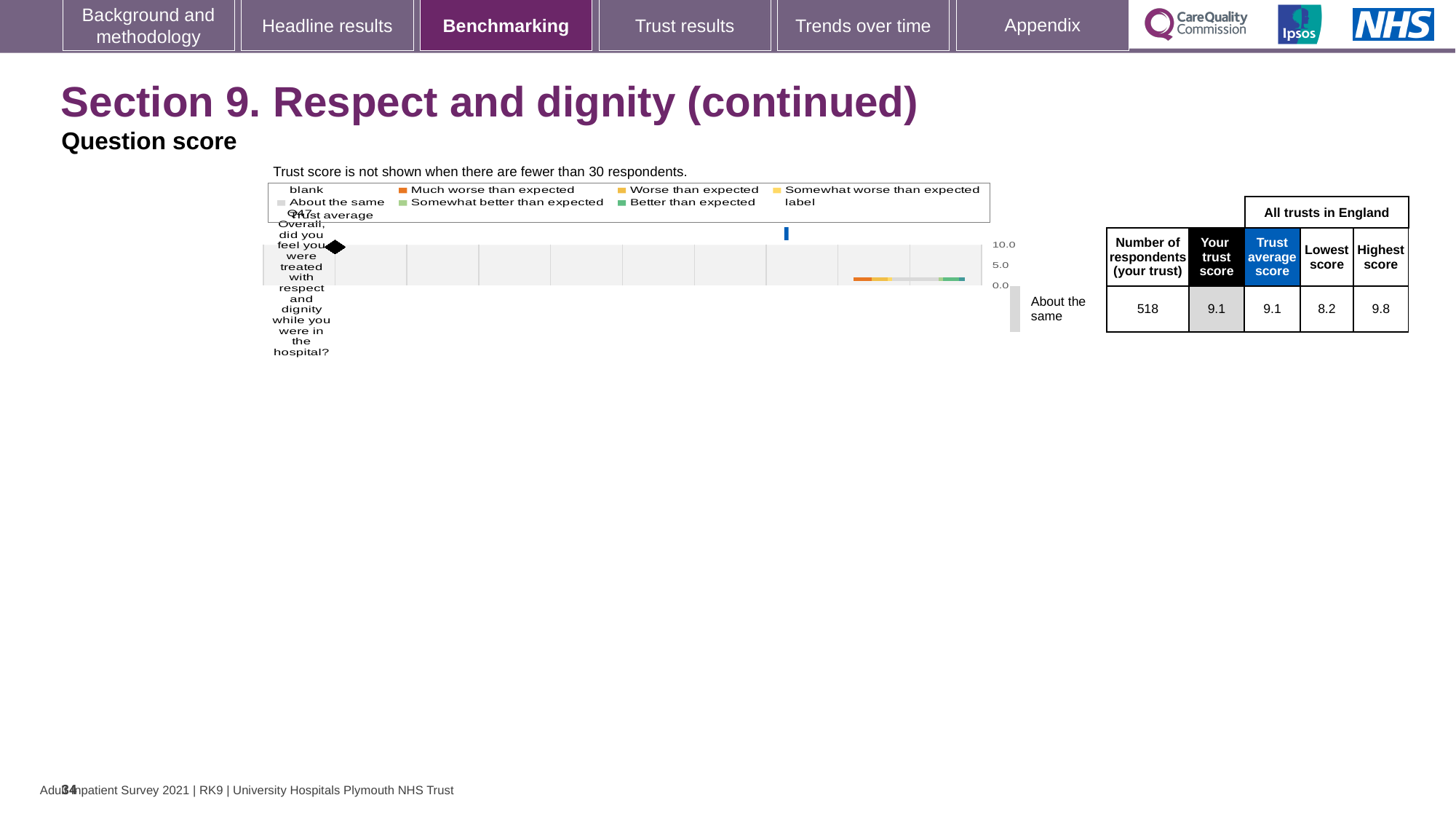
According to the table, what is the lowest score for Q47 among all trusts in England? 8.2 Which question number is plotted on the chart? Q47 According to the table, what is the highest score for Q47 among all trusts in England? 9.8 According to the table, what is the trust average score for Q47 across all trusts in England? 9.1 What is the difference between the highest score and the lowest score for Q47 in the table? 1.6 How many survey questions are plotted on the chart? 1 Which is larger for Q47: the trust's score or the lowest score among all trusts in England? The trust's score According to the table, how many respondents did the trust have for Q47? 518 What kind of chart is shown on the slide? Bar chart According to the table, what is the trust's score for Q47? 9.1 What benchmarking category is the trust's Q47 score assigned to? About the same What is the highest value shown on the chart's score axis? 10.0